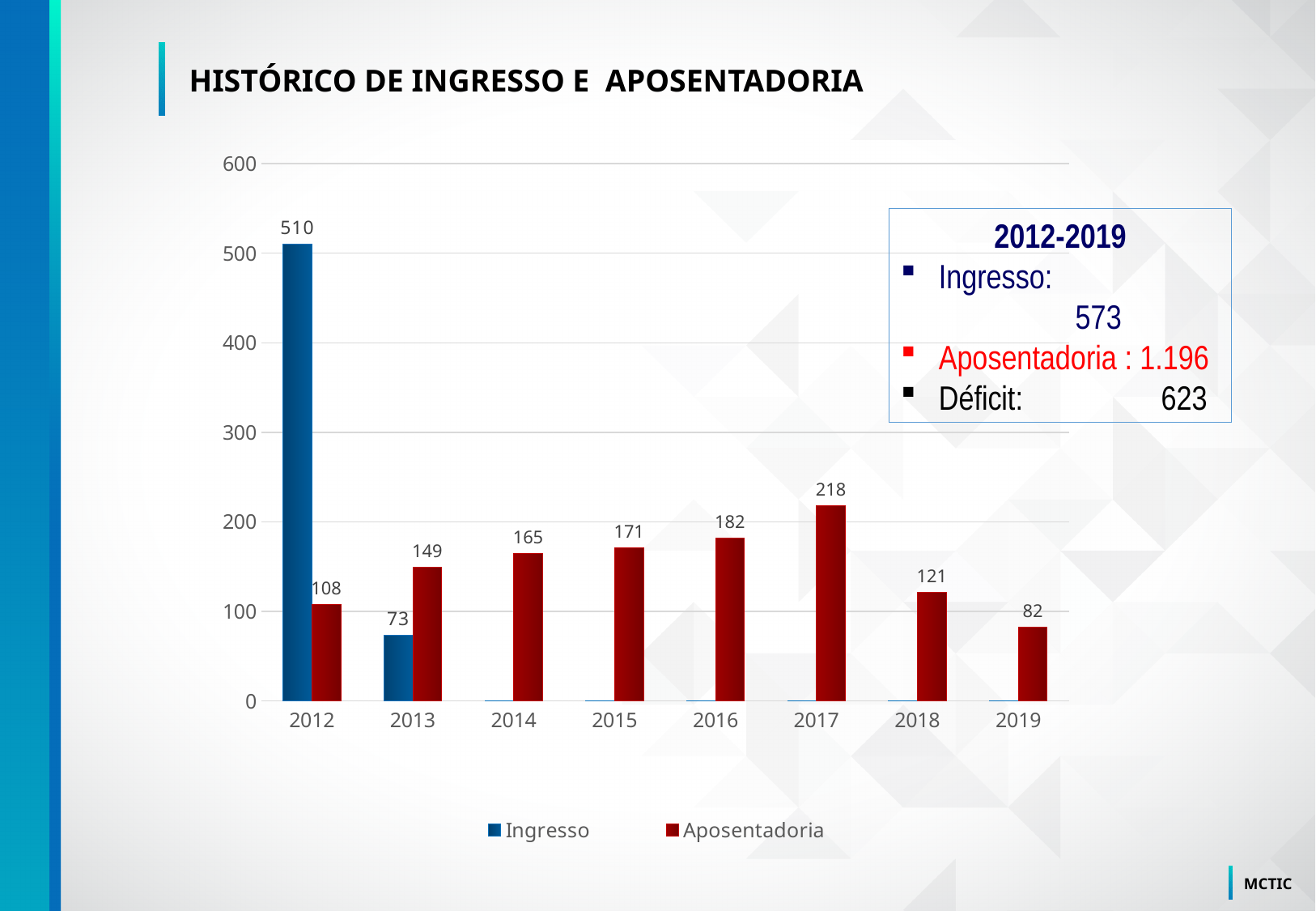
Is the Aposentadoria value for 2016 greater or less than 200? less Do the Aposentadoria values rise or fall from 2013 to 2017? rise In 2013, which is larger: Ingresso or Aposentadoria? Aposentadoria What is the Ingresso value for 2012? 510 Which year has the highest Aposentadoria value? 2017 What is the difference between the Aposentadoria values for 2017 and 2019? 136 What is the Ingresso value for 2013? 73 What is the Aposentadoria value for 2017? 218 Which year has the lowest Aposentadoria value? 2019 How many years are shown on the x axis? 8 How many series does the legend list? 2 What kind of chart is shown on the slide? bar chart